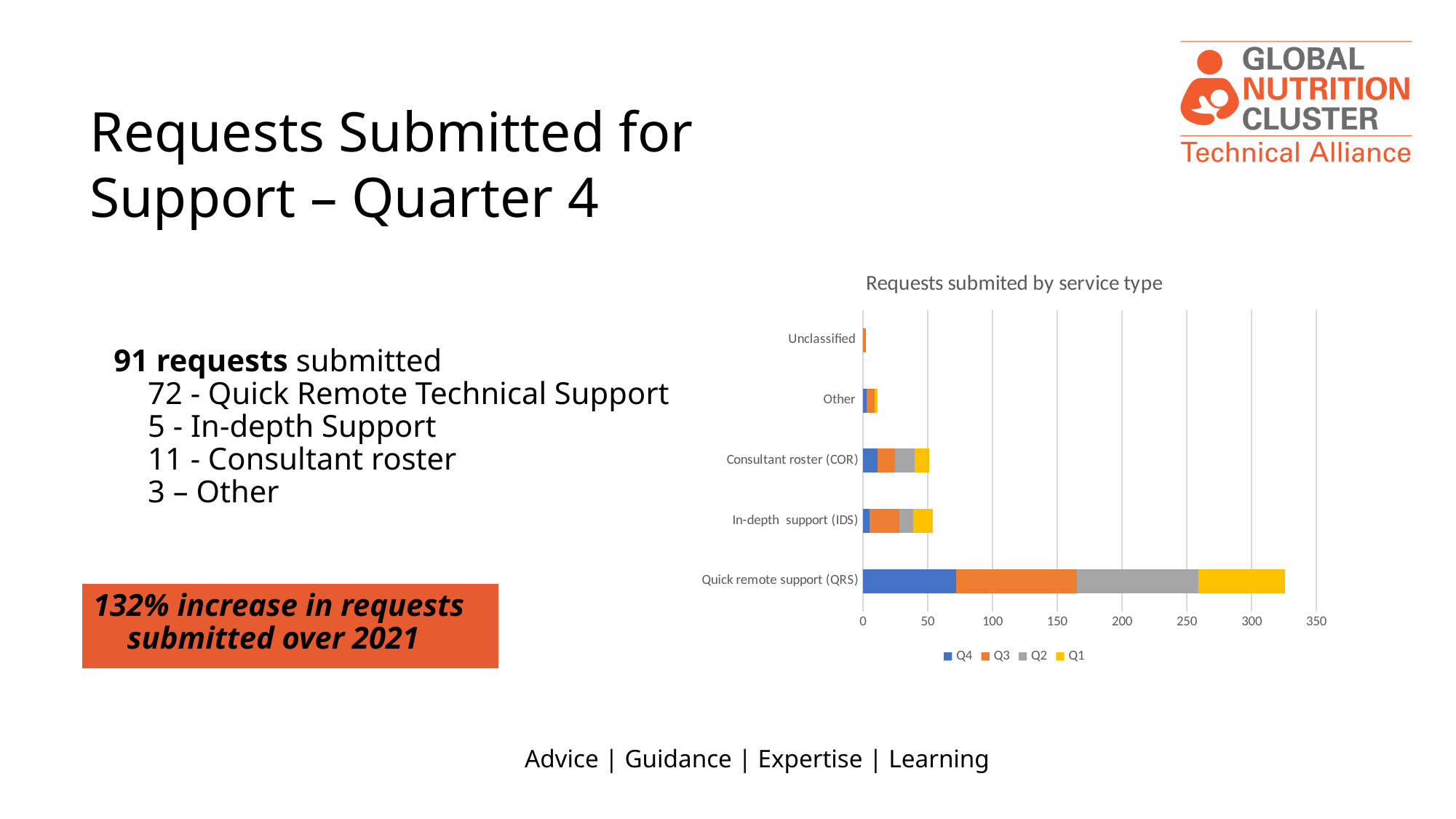
What is the title of the chart? Requests submited by service type Which series are listed in the chart legend? Q4, Q3, Q2, Q1 Which service type has the shortest total bar in the chart? Unclassified Which has a longer total bar: Other or In-depth support (IDS)? In-depth support (IDS) Is the total bar for Unclassified greater or less than 50? less Which service type has the longest total bar in the chart? Quick remote support (QRS) How many series does the chart legend list? 4 Is the total bar for Quick remote support (QRS) greater or less than 300? greater How many service type categories are plotted in the chart? 5 Is the total bar for Other greater or less than 50? less What kind of chart is shown on the slide? Stacked bar chart Which has a longer total bar: Quick remote support (QRS) or Consultant roster (COR)? Quick remote support (QRS)